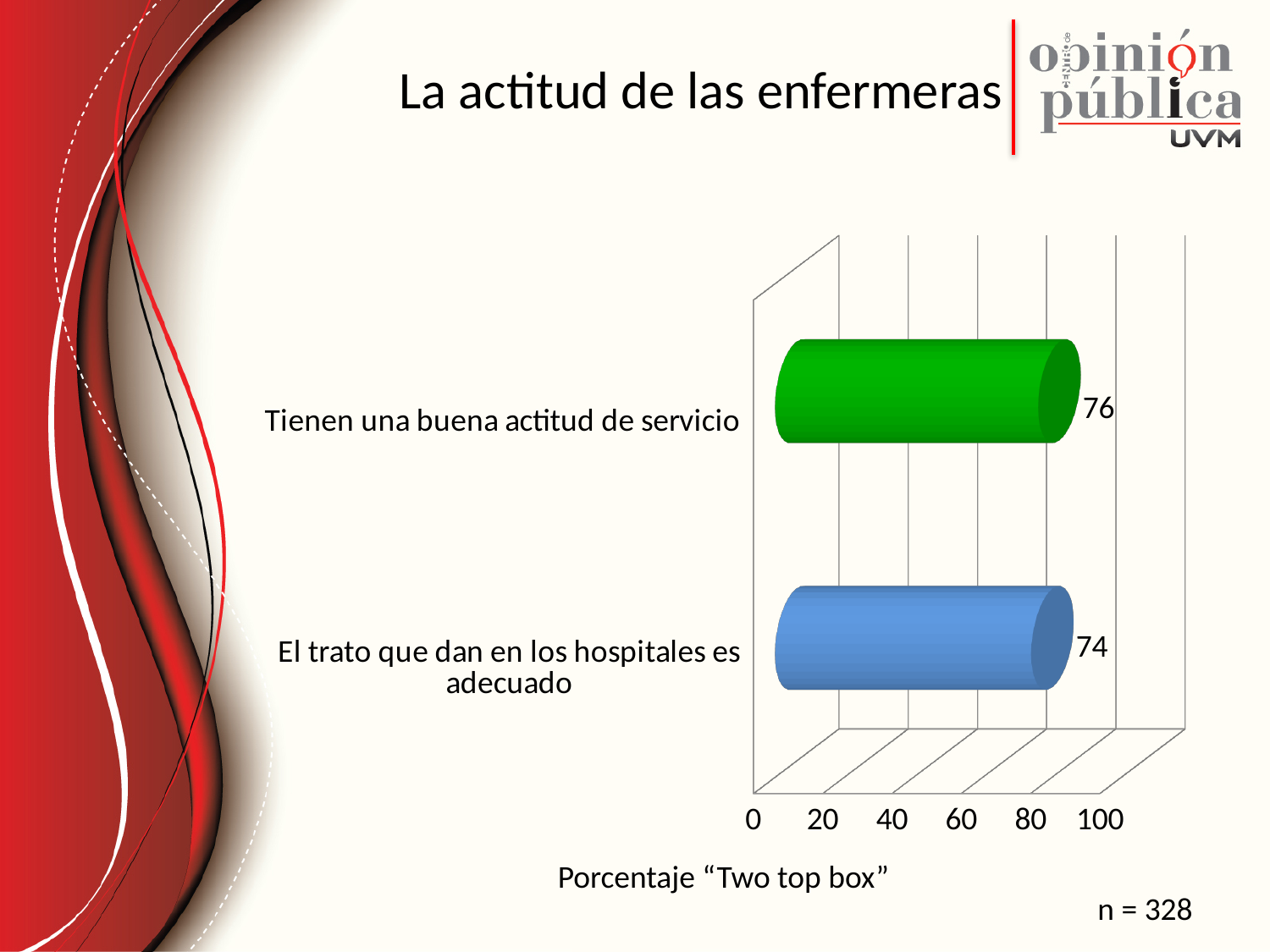
How many categories are shown in the chart? 2 What is the value for "El trato que dan en los hospitales es adecuado"? 74 What is the title of the slide containing the chart? La actitud de las enfermeras What is the value for "Tienen una buena actitud de servicio"? 76 What is the sample size (n) shown on the slide? n = 328 Is the value for "El trato que dan en los hospitales es adecuado" greater or less than 100? less What kind of chart is shown on the slide? Bar chart Which category has the highest value? Tienen una buena actitud de servicio What is the maximum value shown on the horizontal axis? 100 Is the value for "Tienen una buena actitud de servicio" greater or less than 60? greater What is the difference between the values for "Tienen una buena actitud de servicio" and "El trato que dan en los hospitales es adecuado"? 2 Which category has the lowest value? El trato que dan en los hospitales es adecuado